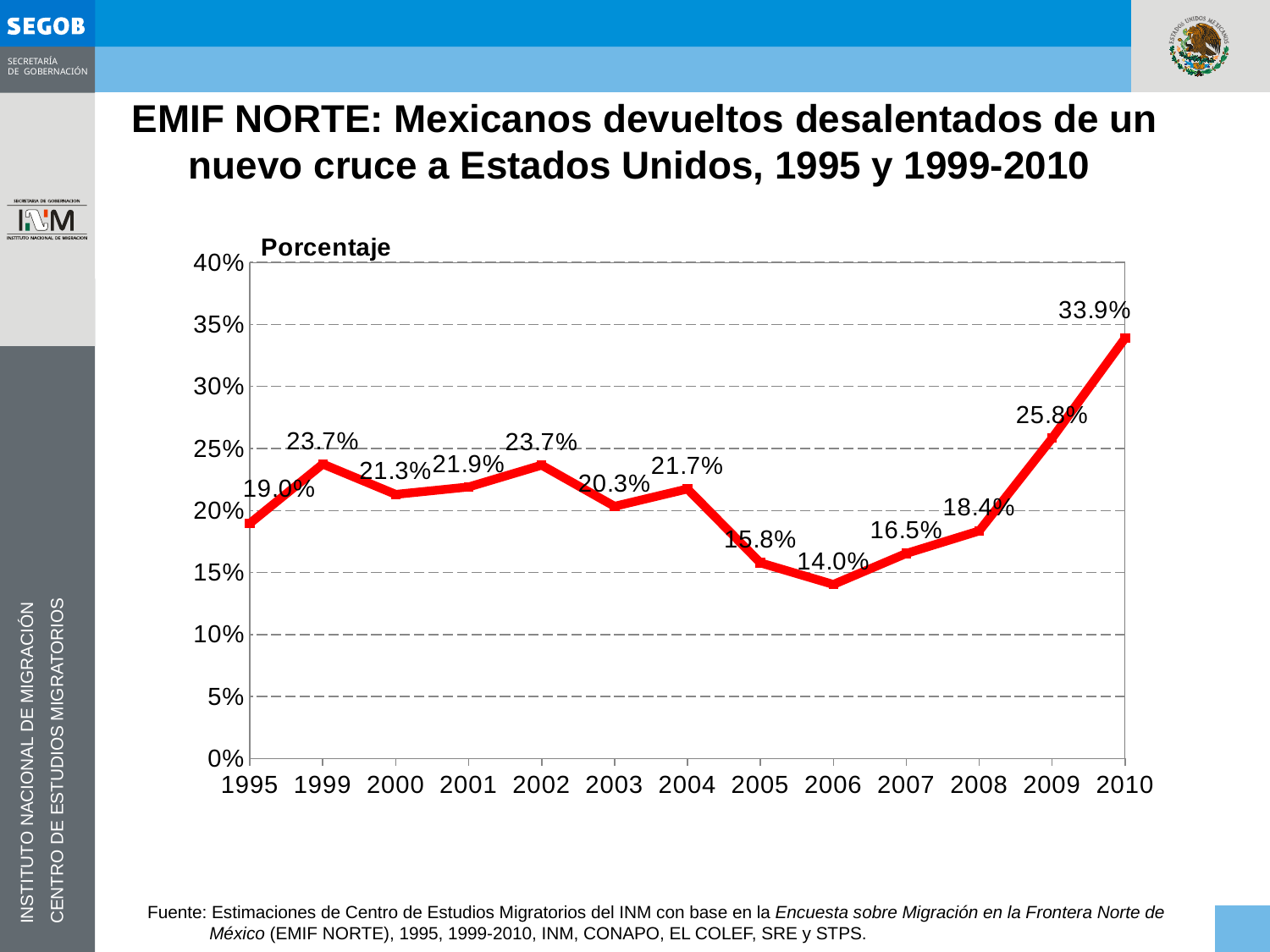
Which year has the highest value? 2010 What is the value for 1995? 19.0% What label is shown above the vertical axis of the chart? Porcentaje How many years are plotted on the x axis? 13 What is the value for 2010? 33.9% Which year has the lowest value? 2006 What is the value for 2009? 25.8% What is the value for 2006? 14.0% Which is larger, the value for 2005 or the value for 2007? 2007 What type of chart is shown on the slide? Line chart Do the values rise or fall from 2006 to 2010? Rise What is the difference between the values for 2010 and 2009? 8.1%